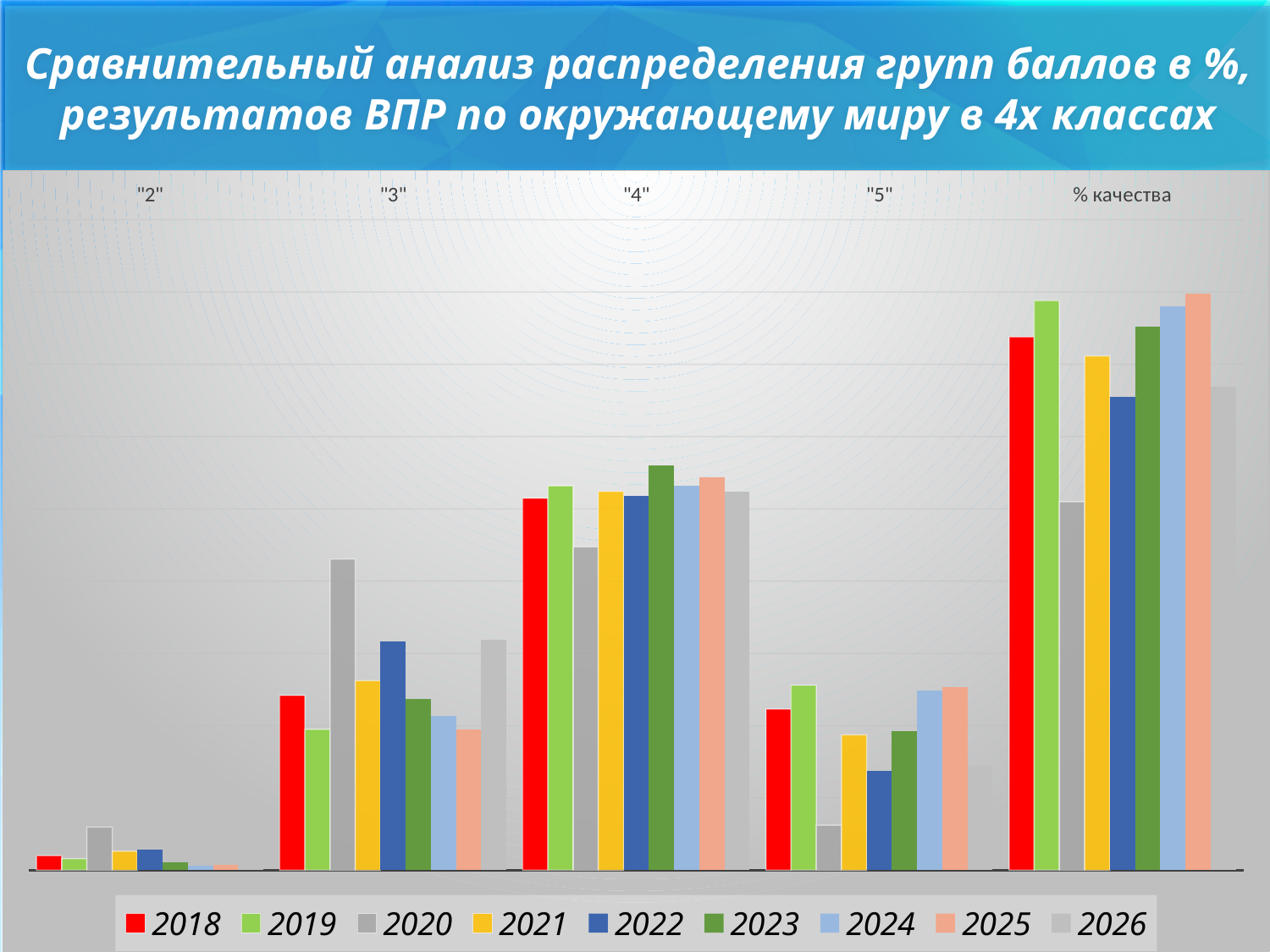
What kind of chart is shown on the slide? bar chart In the "4" category, which is larger: the value for 2018 or for 2023? 2023 In the "2" category, which year has the highest bar? 2020 For 2018, which category has the larger value: "2" or "4"? "4" In the "% качества" category, which is larger: the value for 2019 or for 2022? 2019 In the "3" category, which year has the highest bar? 2020 In the "4" category, which year has the highest bar? 2023 Which category has the lowest values overall? "2" How many categories are shown along the x axis? 5 How many series does the legend list? 9 What colour represents the 2018 series in the legend? red